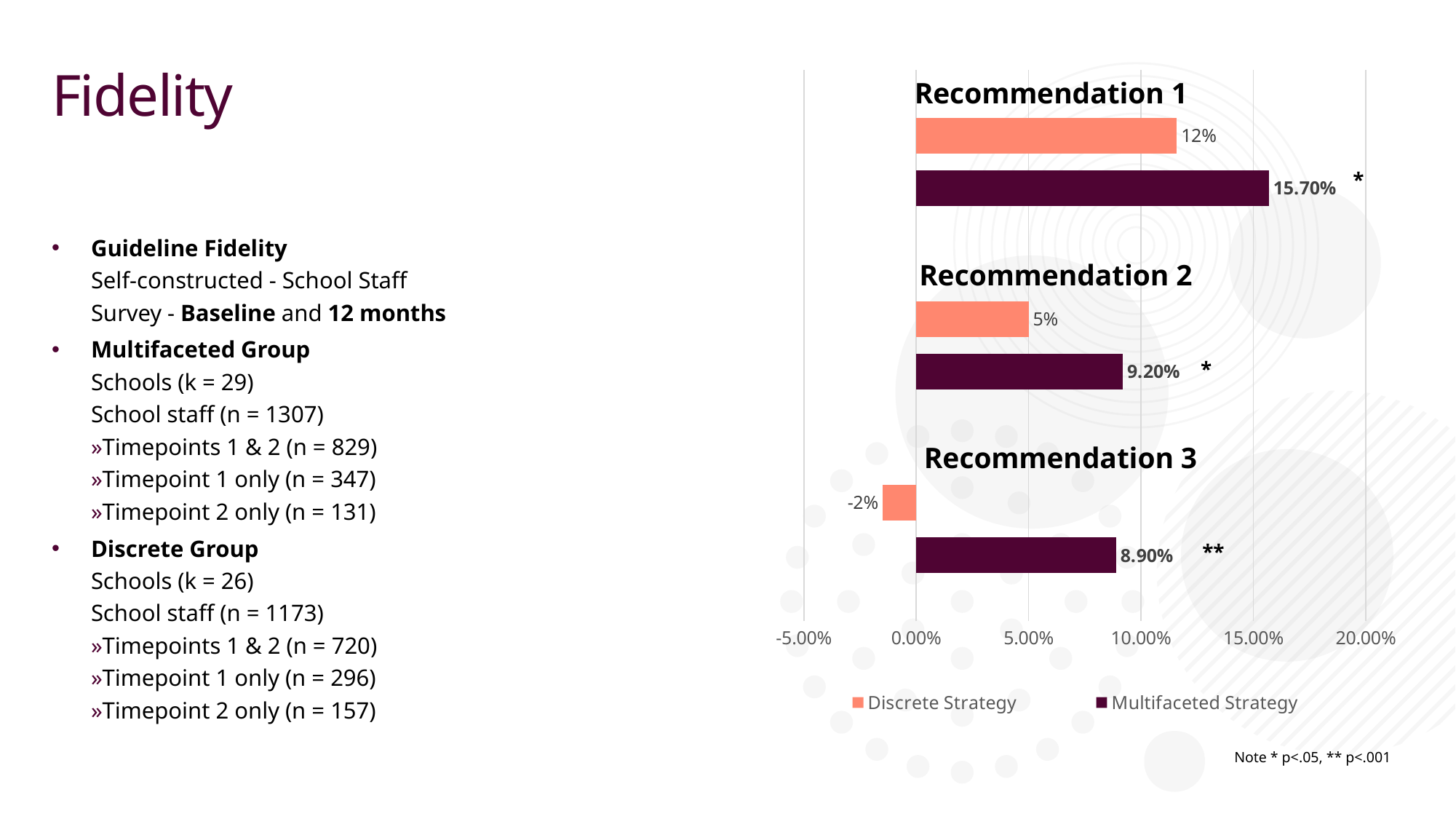
Is the Multifaceted Strategy value for Recommendation 1 greater or less than 10.00%? greater How many series does the legend list? 2 Which recommendation has the highest Multifaceted Strategy value? Recommendation 1 What is the value for Discrete Strategy for Recommendation 3? -2% For Recommendation 2, which is larger: the Discrete Strategy value or the Multifaceted Strategy value? Multifaceted Strategy What is the value for Discrete Strategy for Recommendation 1? 12% What is the difference between the Multifaceted Strategy and Discrete Strategy values for Recommendation 1? 3.70% Which recommendation has the lowest Discrete Strategy value? Recommendation 3 What kind of chart is shown on the slide? bar chart How many recommendations are shown in the chart? 3 What is the value for Multifaceted Strategy for Recommendation 3? 8.90% What is the value for Multifaceted Strategy for Recommendation 2? 9.20%